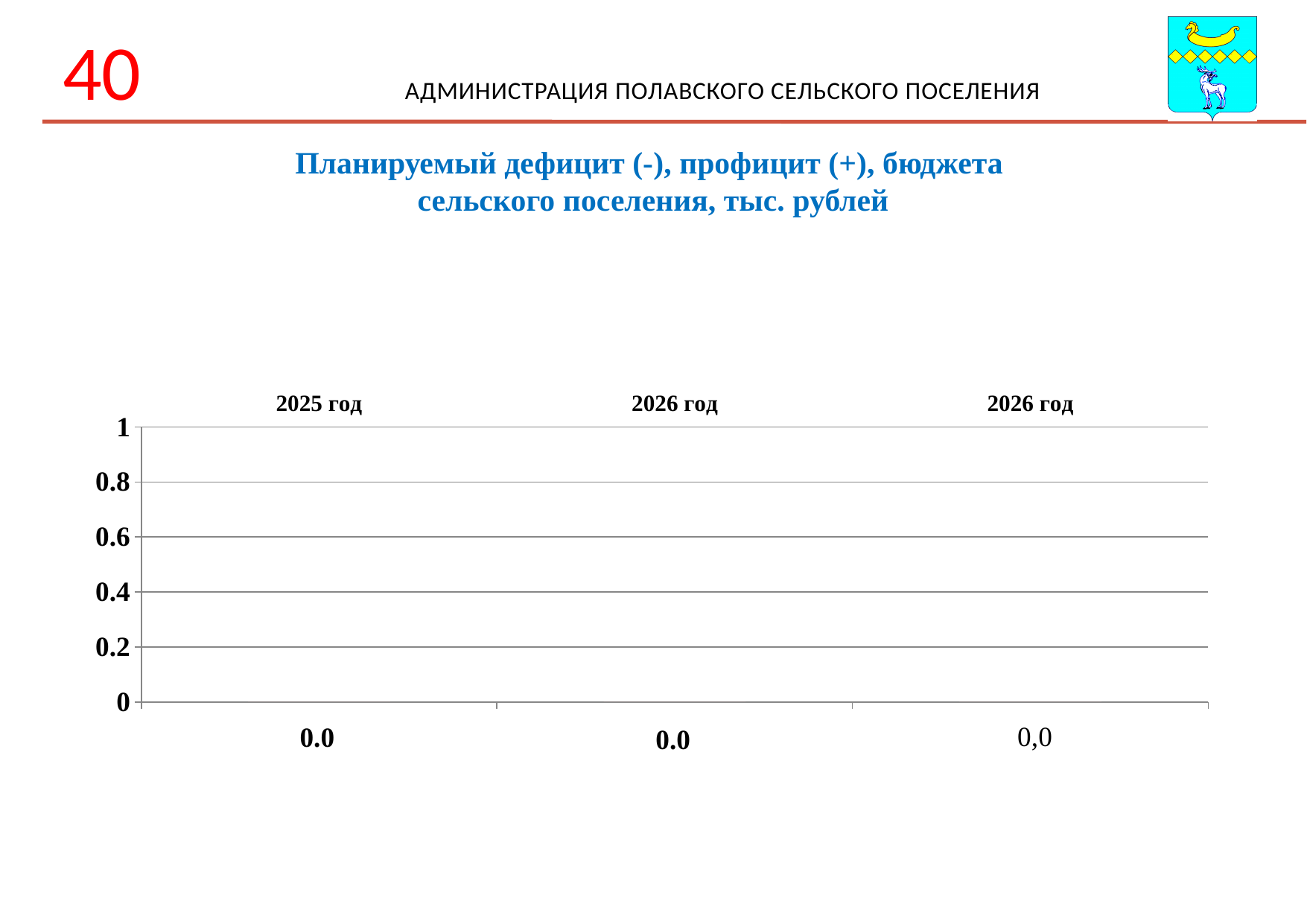
What is the difference between the value for 2025 год and the value for the middle 2026 год category? 0.0 What is the title of the chart? Планируемый дефицит (-), профицит (+), бюджета сельского поселения, тыс. рублей What is the value shown for 2025 год? 0.0 What is the label of the leftmost category on the x axis? 2025 год Is the value for 2025 год greater or less than 0.2? less Do the values rise, fall, or stay flat across the categories from left to right? stay flat What is the value shown for the rightmost category? 0,0 What is the value shown for the middle category (the first 2026 год)? 0.0 What is the highest tick value shown on the vertical axis? 1 How many categories are shown along the x axis of the chart? 3